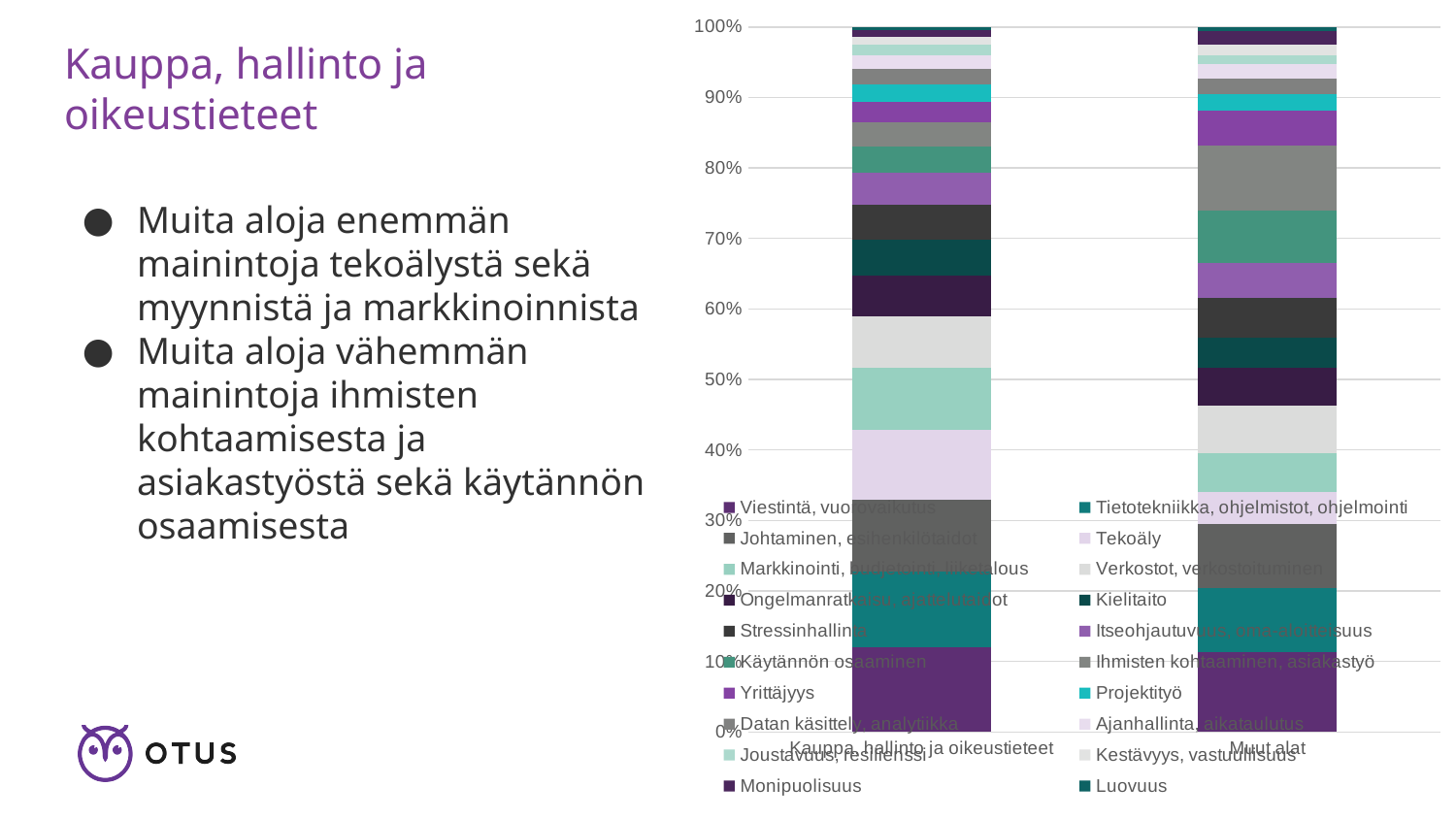
How many series does the chart's legend list? 20 What is the total height of the stacked bar for Muut alat? 100% What are the two category labels on the x axis of the chart? Kauppa, hallinto ja oikeustieteet; Muut alat What kind of chart is shown on the slide? Stacked bar chart What is the highest value shown on the chart's y axis? 100% What is the total height of the stacked bar for Kauppa, hallinto ja oikeustieteet? 100% How many categories are shown on the x axis of the chart? 2